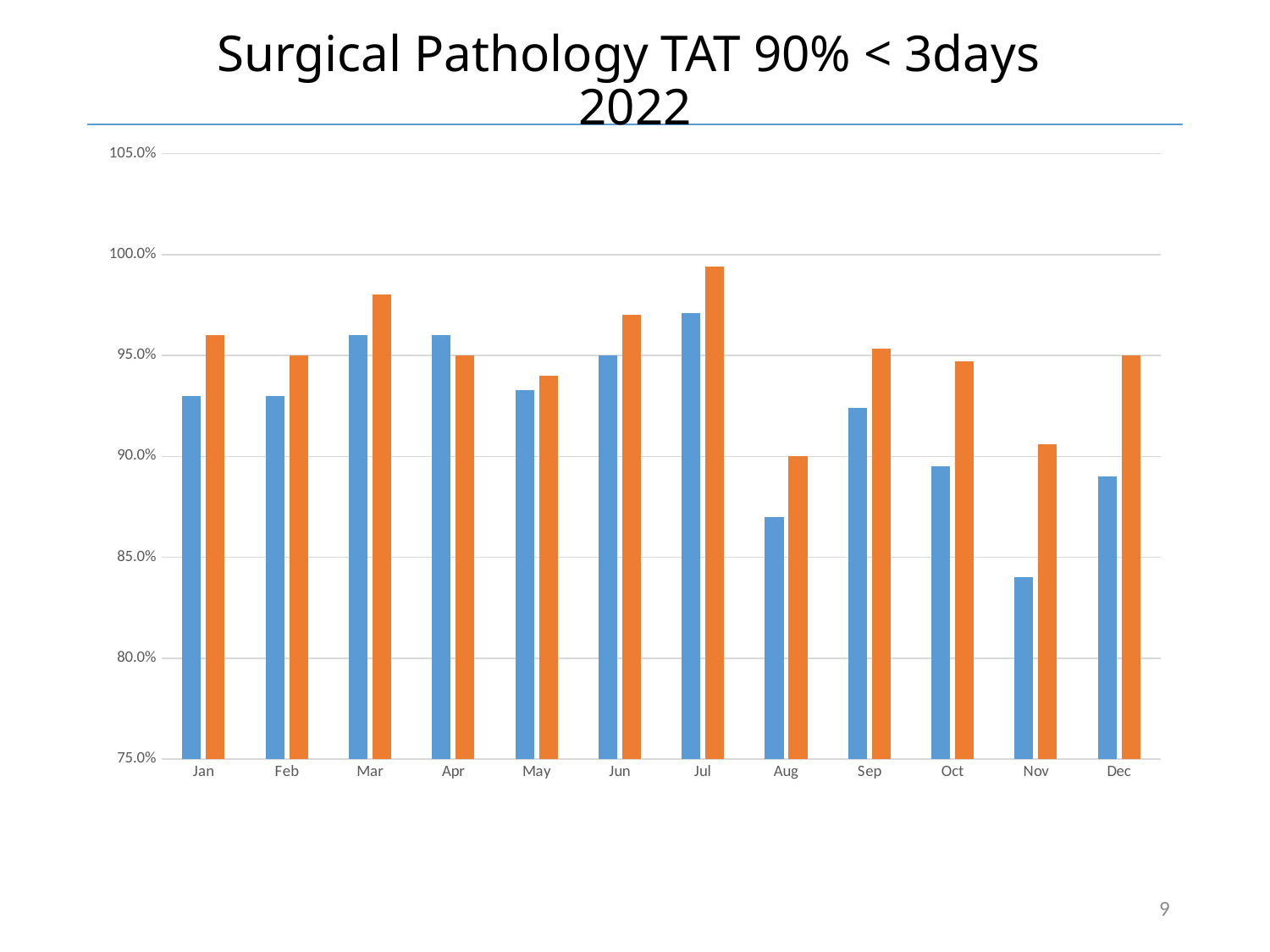
Which is larger, the orange bar for Mar or the orange bar for Feb? Mar Is the orange bar for Jul greater or less than 95.0%? greater What two colours are the bars in the chart? blue and orange What kind of chart is shown on the slide? bar chart In which month is the blue bar the highest? Jul What is the title of the chart? Surgical Pathology TAT 90% < 3days 2022 How many months are shown on the x axis of the chart? 12 In which month is the orange bar the highest? Jul In which month is the blue bar the lowest? Nov Is the blue bar for Aug greater or less than 90.0%? less Is the blue bar for Nov greater or less than 85.0%? less How many bars are plotted for each month? 2